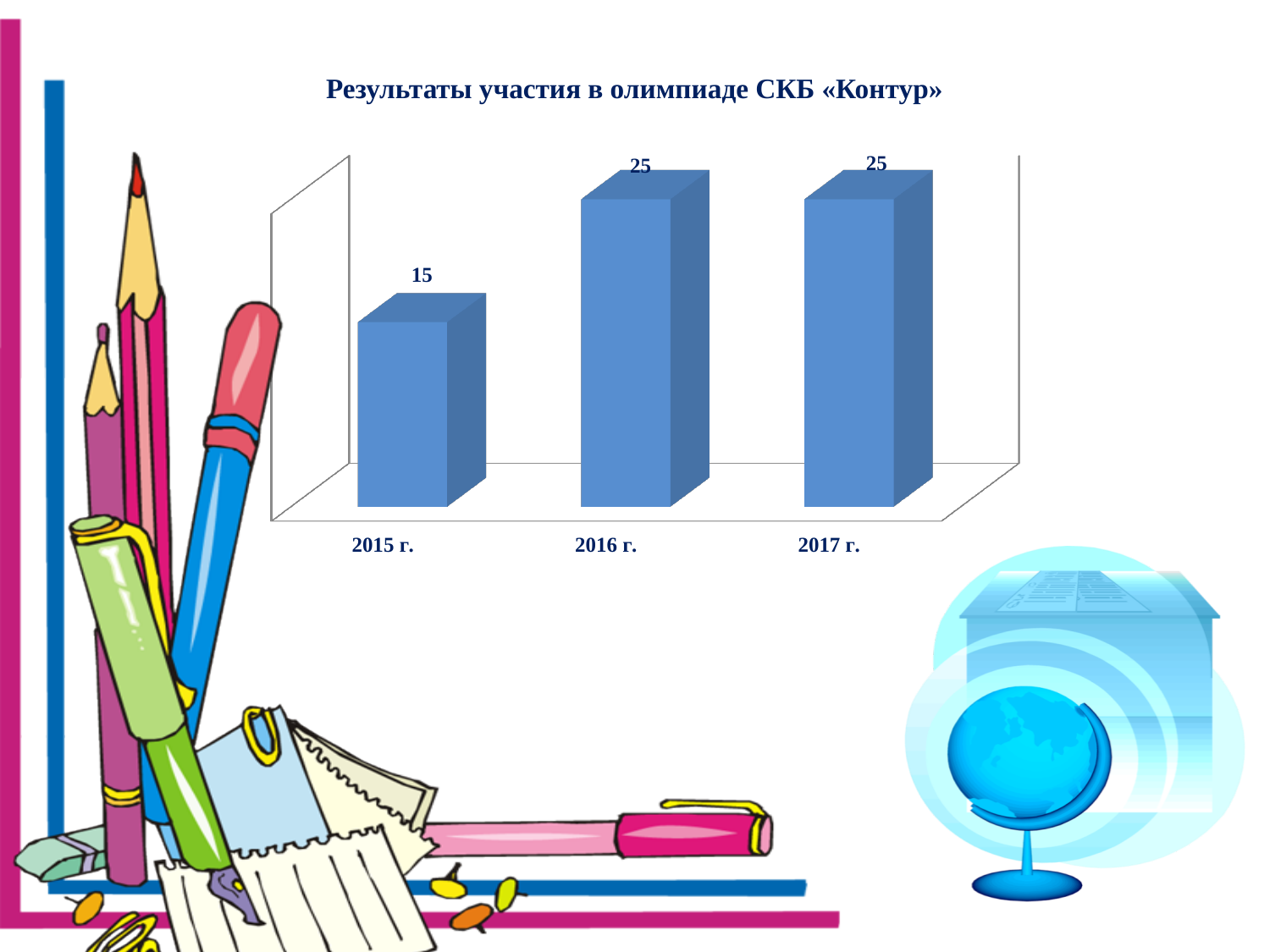
What is the value for 2015 г.? 15 Do the values rise or fall from 2015 г. to 2016 г.? rise What is the value for 2017 г.? 25 What is the difference between the values for 2016 г. and 2015 г.? 10 How many categories are shown on the chart? 3 What is the value for 2016 г.? 25 Which year has the lowest value? 2015 г. What is the title of the chart? Результаты участия в олимпиаде СКБ «Контур» What colour are the bars in the chart? blue What kind of chart is shown on the slide? bar chart Which is larger, the value for 2015 г. or the value for 2017 г.? 2017 г.